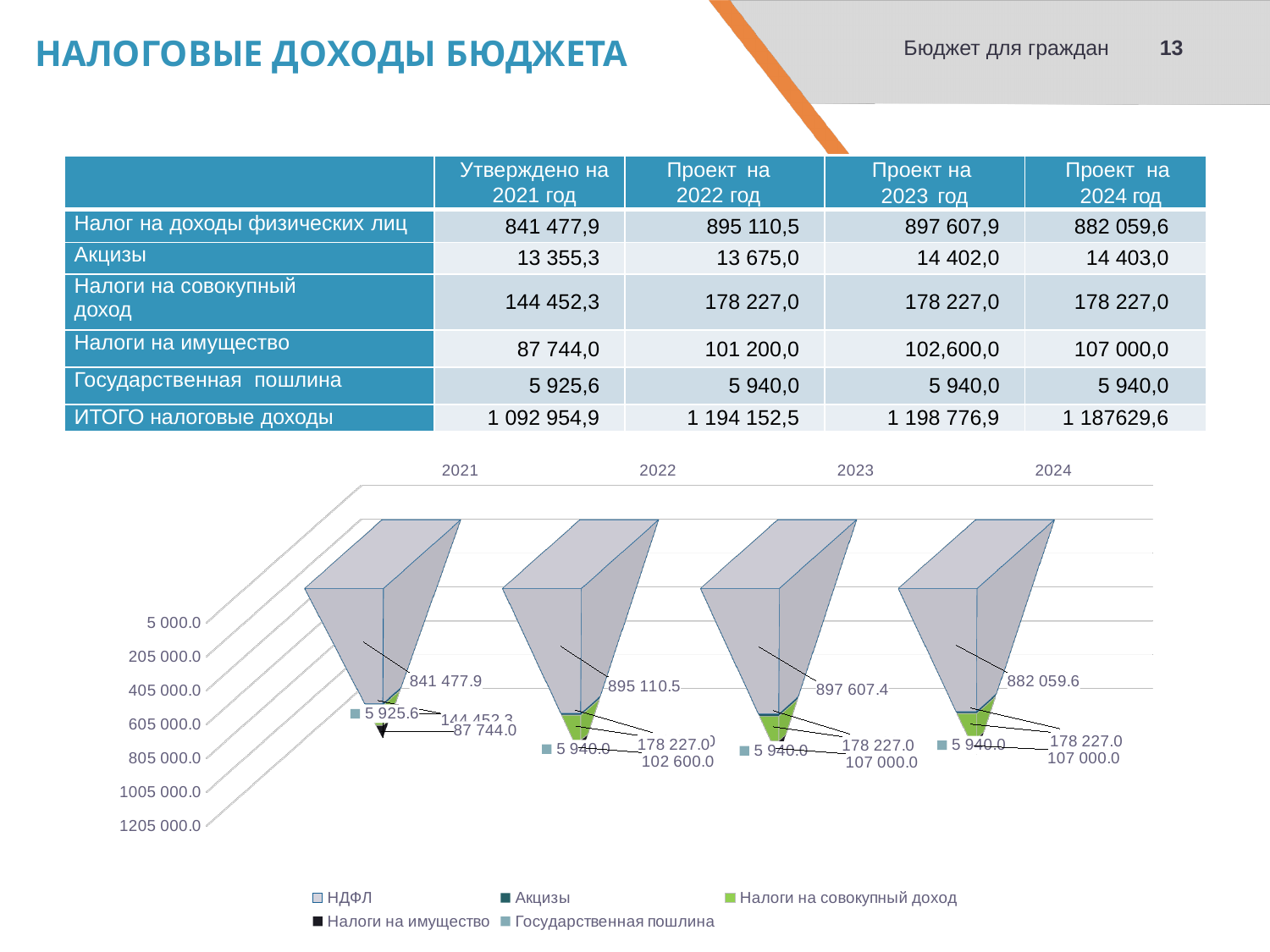
What is the value of Налоги на совокупный доход for 2023 on the chart? 178 227.0 What is the value of Государственная пошлина for 2022 on the chart? 5 940.0 Does the НДФЛ value rise or fall from 2021 to 2022 on the chart? rise What is the value of НДФЛ for 2022 on the chart? 895 110.5 How many series does the chart legend list? 5 Which is larger on the chart: the НДФЛ value for 2024 or for 2021? 2024 Which year has the lowest НДФЛ value on the chart? 2021 What is the value of Налоги на имущество for 2021 on the chart? 87 744.0 What is the difference between the НДФЛ values for 2022 and 2021 on the chart? 53 632.6 What is the value of НДФЛ for 2021 on the chart? 841 477.9 What is the value of НДФЛ for 2024 on the chart? 882 059.6 How many years are shown on the x axis of the chart? 4